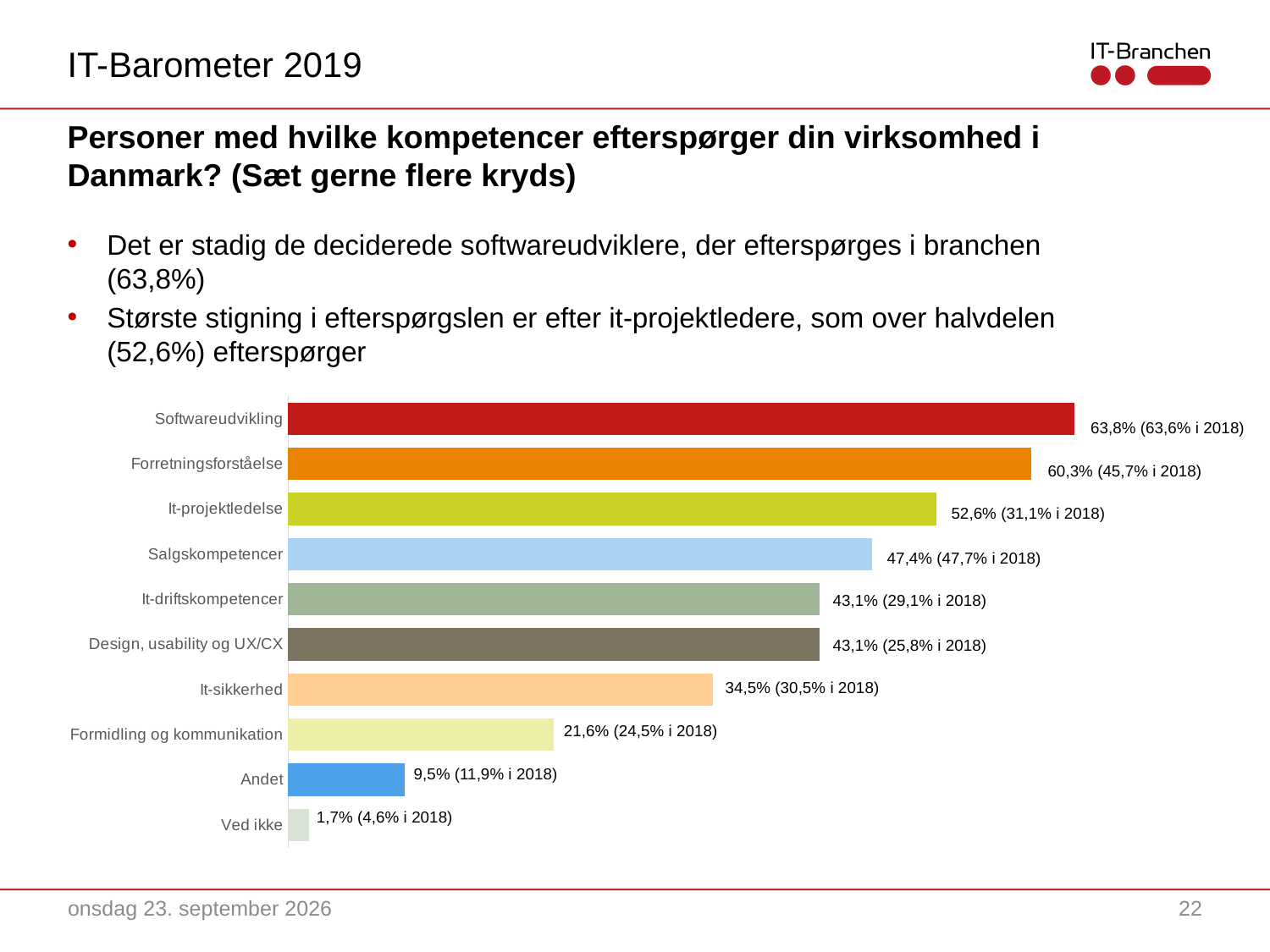
What is the difference between the 2019 values for Softwareudvikling and Forretningsforståelse? 3,5% Which category has the lowest 2019 value? Ved ikke What is the 2019 value for It-projektledelse? 52,6% What is the 2019 value for Ved ikke? 1,7% Which two categories share the same 2019 value of 43,1%? It-driftskompetencer and Design, usability og UX/CX How many categories are shown in the chart? 10 What is the 2019 value for Softwareudvikling? 63,8% What was the 2018 value for Forretningsforståelse, as shown in the data label? 45,7% What is the difference between the 2019 and 2018 values for It-projektledelse? 21,5% What kind of chart is shown on the slide? Bar chart Which category has the highest 2019 value? Softwareudvikling Which has a larger 2019 value, Salgskompetencer or It-sikkerhed? Salgskompetencer